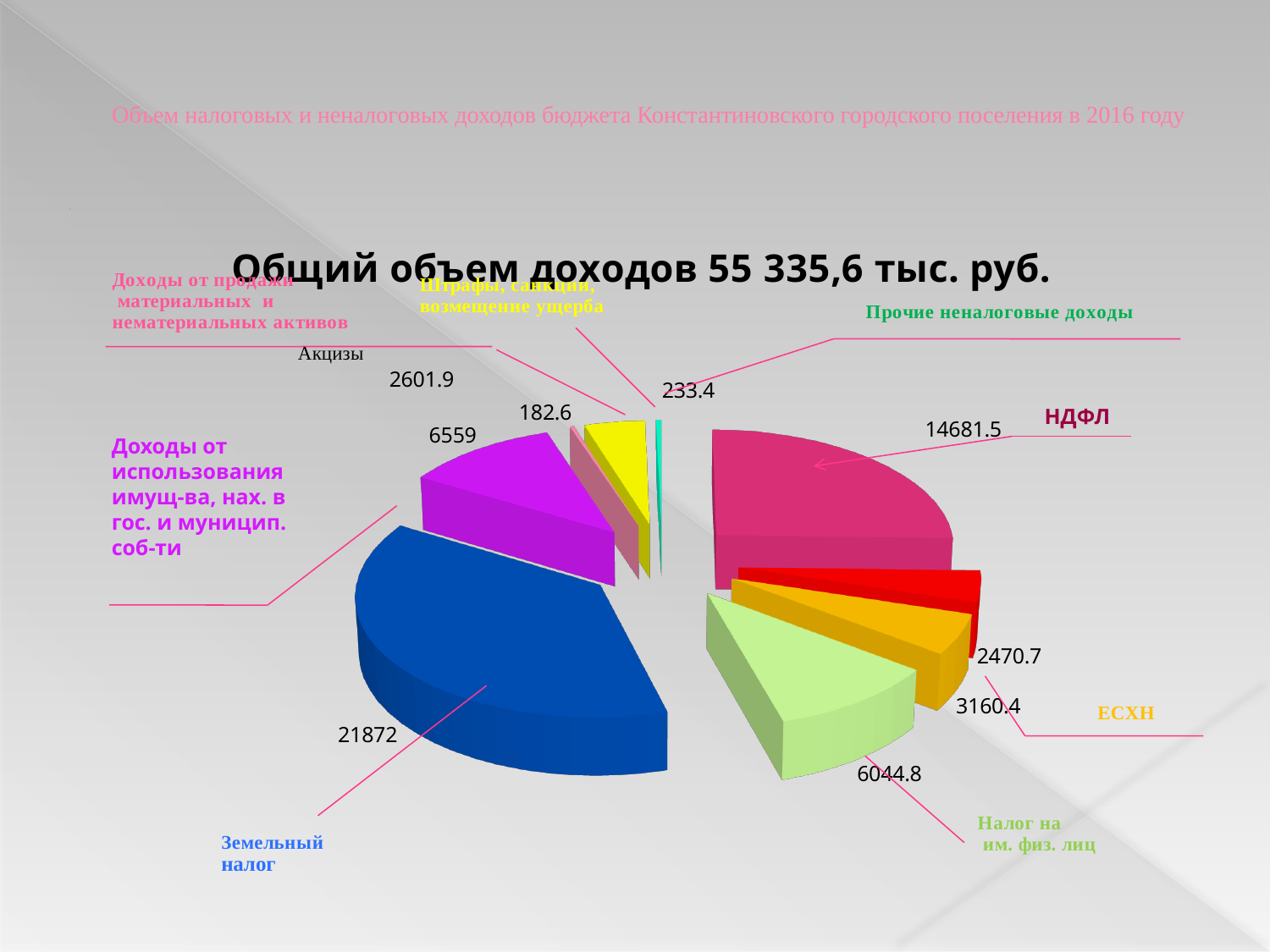
Which category has the largest slice of the pie? Земельный налог What total income amount is stated in the chart title? 55 335,6 тыс. руб. What kind of chart is shown on the slide? pie chart How many slices does the pie chart have? 9 Which is larger, НДФЛ or Земельный налог? Земельный налог What is the value of the НДФЛ slice? 14681.5 What is the value for Налог на им. физ. лиц? 6044.8 What is the value for Прочие неналоговые доходы? 233.4 What is the value of the ЕСХН slice? 3160.4 What is the value for Доходы от использования имущ-ва, нах. в гос. и муницип. соб-ти? 6559 What is the value of the Земельный налог slice? 21872 What is the difference between the Земельный налог value and the НДФЛ value? 7190.5